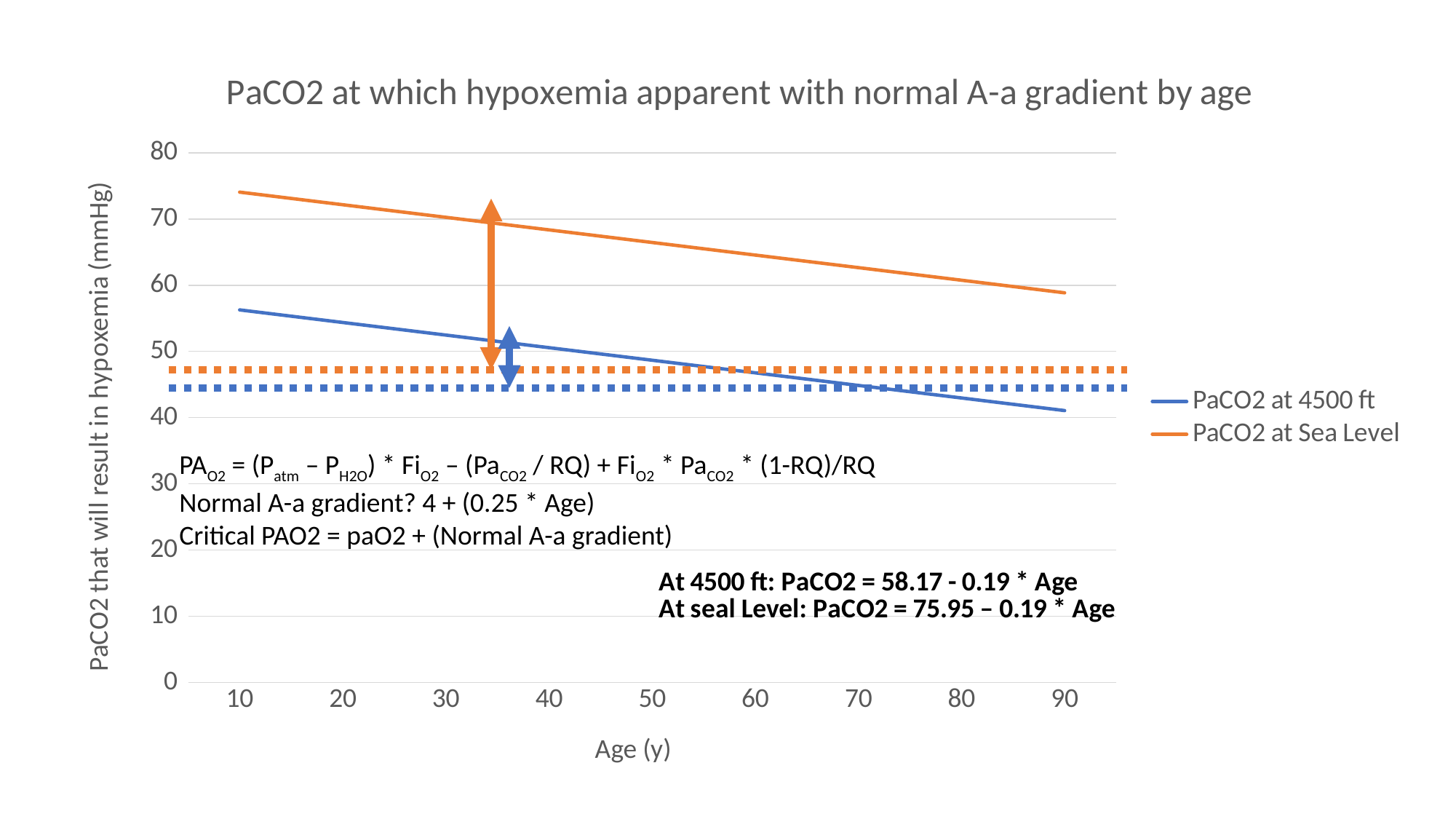
Is the value for PaCO2 at 4500 ft at age 90 greater or less than 50? less How many series does the legend list? 2 Do the values for PaCO2 at Sea Level rise or fall as age increases? fall Is the value for PaCO2 at 4500 ft at age 10 greater or less than 50? greater What is the title of the chart? PaCO2 at which hypoxemia apparent with normal A-a gradient by age Do the values for PaCO2 at 4500 ft rise or fall as age increases? fall What kind of chart is shown on the slide? line chart At age 50, which series has the higher value, PaCO2 at 4500 ft or PaCO2 at Sea Level? PaCO2 at Sea Level Is the value for PaCO2 at 4500 ft at age 70 greater or less than 50? less What is the label of the x axis? Age (y)